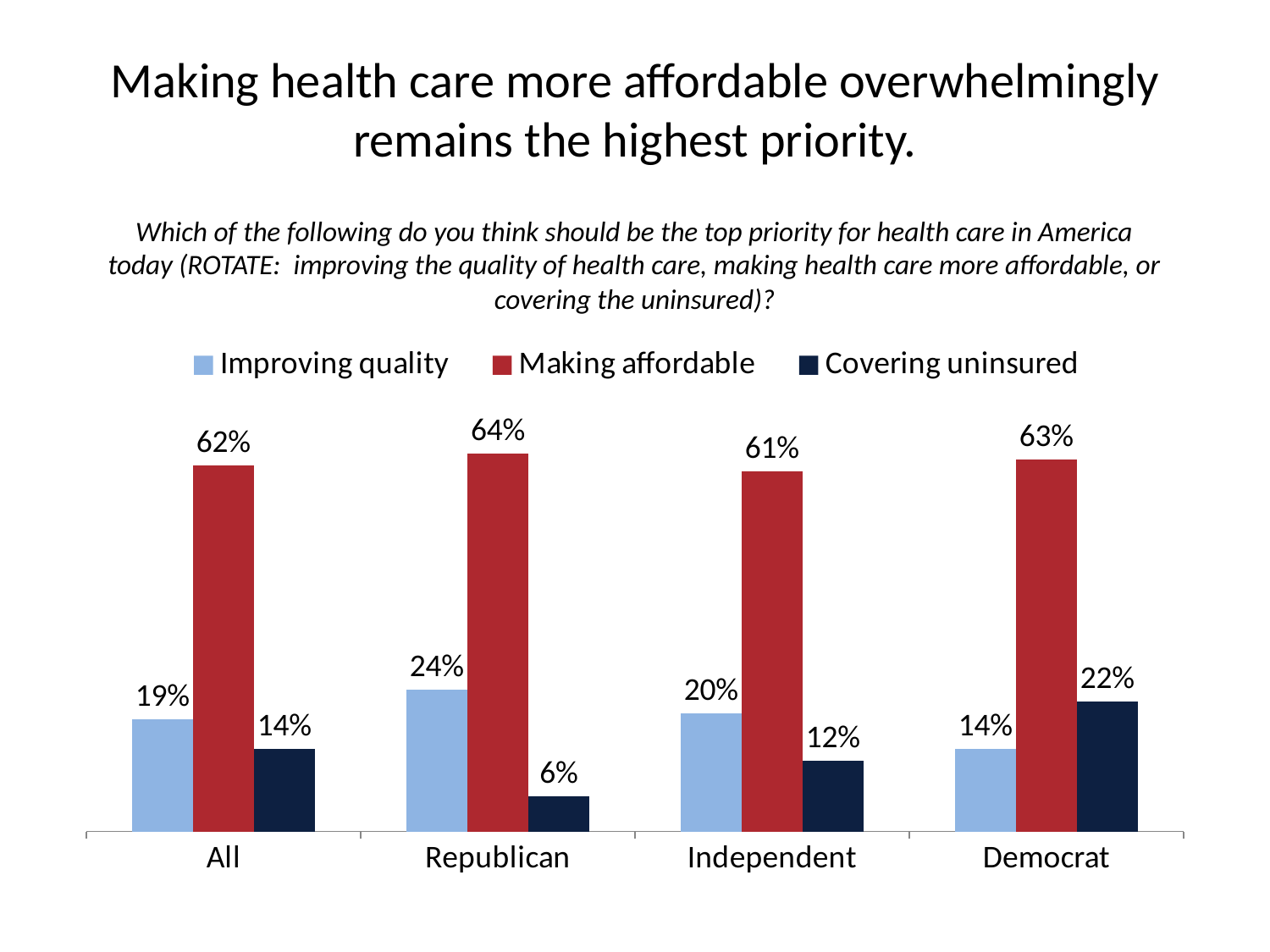
What is the value for "Improving quality" in the All group? 19% What percentage of Republicans chose "Making affordable" as the top priority? 64% What is the value for "Covering uninsured" among Democrats? 22% Which is larger for Democrats: "Improving quality" or "Covering uninsured"? Covering uninsured Which group has the lowest value for "Covering uninsured"? Republican What is the difference between "Making affordable" and "Improving quality" for Independents? 41 percentage points How many series does the legend list? 3 What kind of chart is shown on the slide? Bar chart What colour are the "Making affordable" bars? Red Which group has the highest value for "Improving quality"? Republican How many groups are shown on the x axis? 4 What is the difference between the "Covering uninsured" values for Democrats and Republicans? 16 percentage points